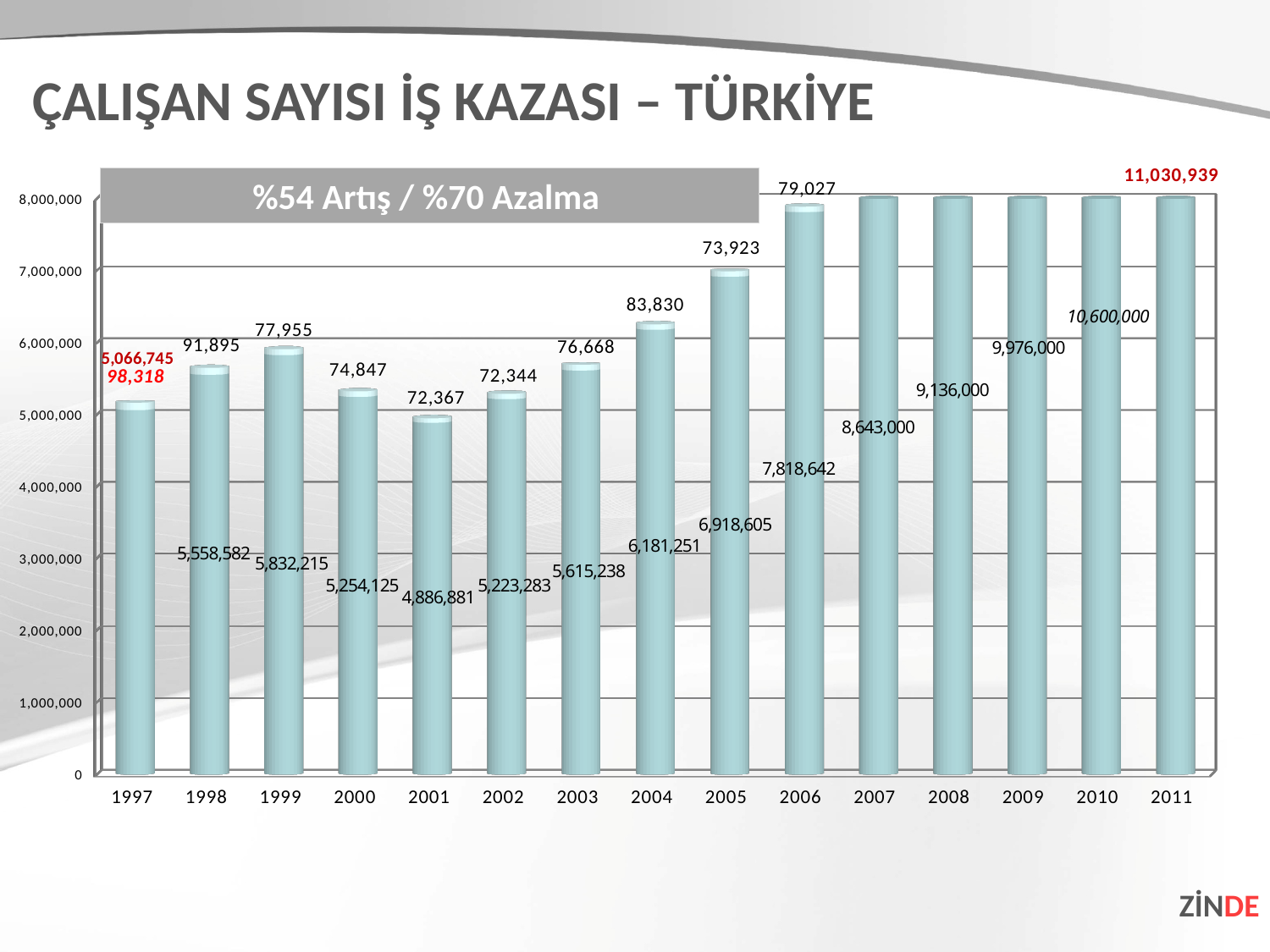
What is the number of work accidents (iş kazası) labelled for 1997? 98,318 Which year has the lowest labelled number of workers? 2001 What is the number of workers labelled for 2011? 11,030,939 What type of chart is shown on the slide? bar chart What is the difference between the number of workers in 2010 and in 2009? 624,000 What is the number of workers (çalışan sayısı) labelled for 2001? 4,886,881 Which year has a larger labelled number of workers, 1998 or 2000? 1998 Is the number of workers for 2005 greater or less than 6,000,000? greater How many years are shown on the x axis of the chart? 15 What text is shown in the grey box at the top of the chart? %54 Artış / %70 Azalma Which year has the highest labelled number of workers? 2011 What is the number of work accidents labelled for 2004? 83,830